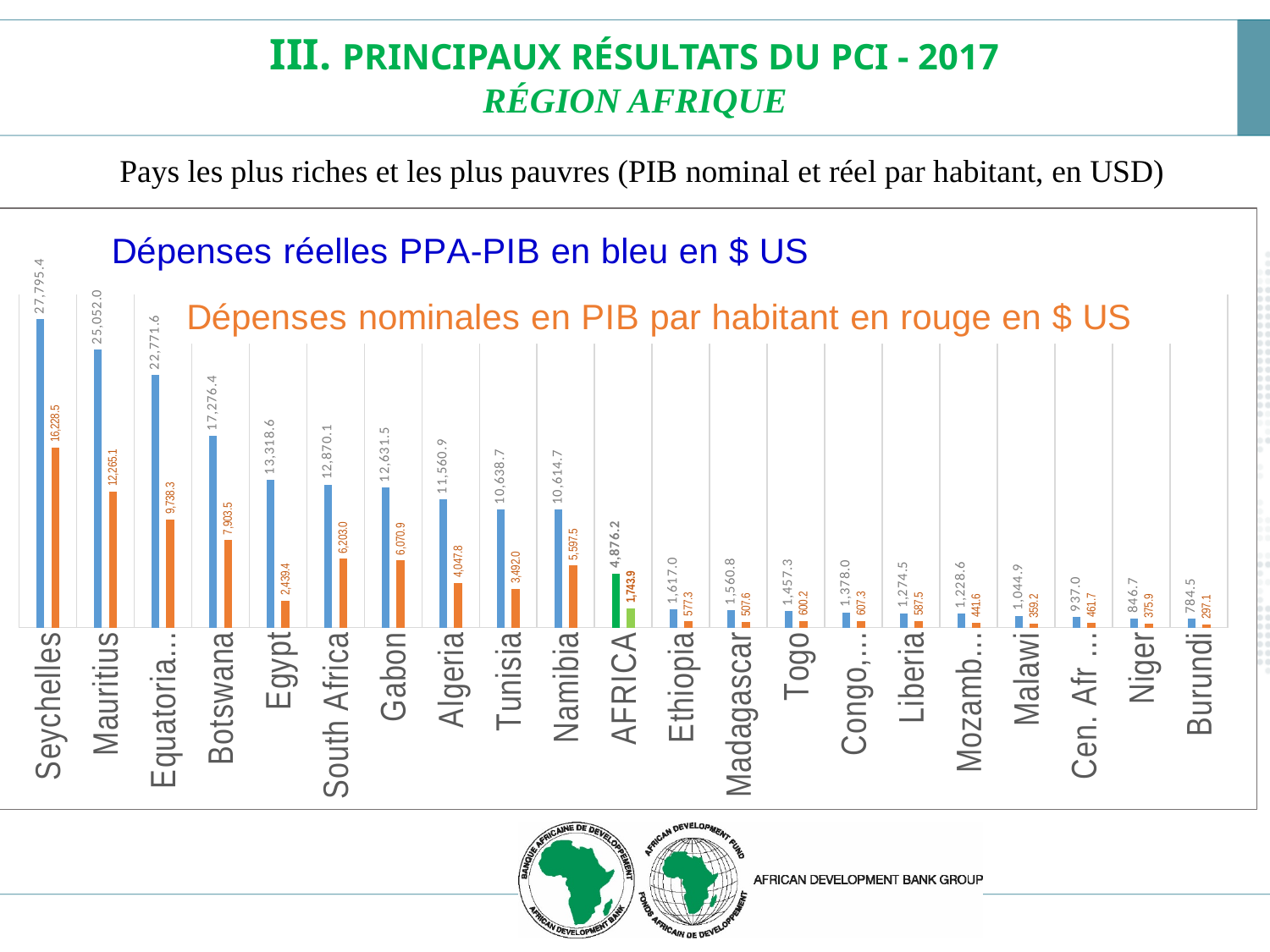
Which has the larger nominal GDP per capita (orange bar): Egypt or South Africa? South Africa What is the real PPP-GDP expenditure (blue bar) value for Seychelles? 27,795.4 What is the real PPP-GDP value shown for AFRICA? 4,876.2 What is the difference between the real PPP-GDP value and the nominal value for Seychelles? 11,566.9 How many countries/regions are shown on the x axis of the chart? 21 What is the nominal GDP per capita (orange bar) value for Mauritius? 12,265.1 Do the real PPP-GDP (blue) values rise or fall from left to right along the x axis? Fall Which country has the lowest nominal GDP per capita (orange bar)? Burundi What kind of chart is shown on the slide? Bar chart What is the nominal GDP per capita value for Burundi? 297.1 What colour are the bars for AFRICA? Green Which country has the highest real PPP-GDP expenditure (blue bar)? Seychelles